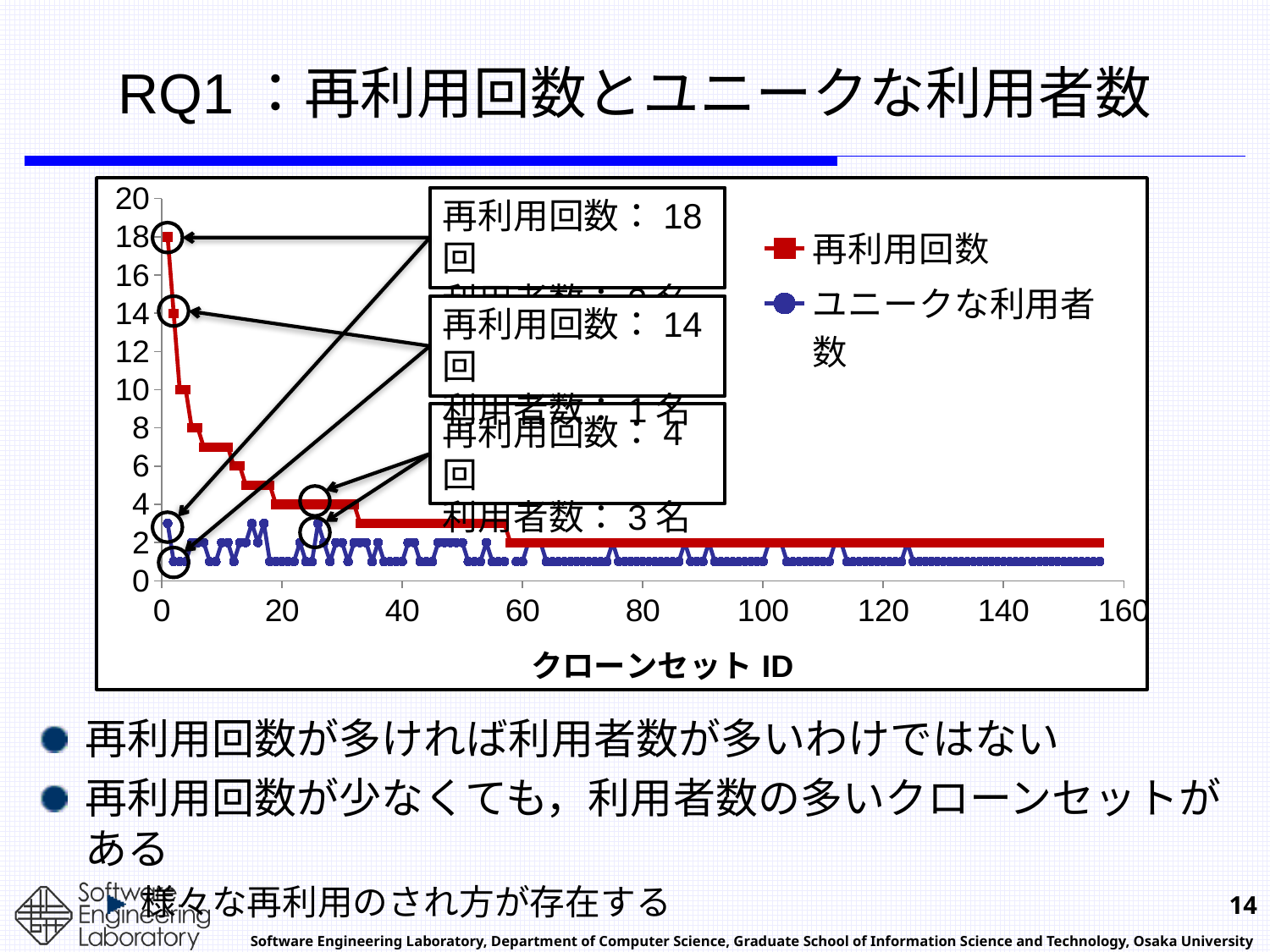
According to the callout, how many users (利用者数) does the clone set with 14 reuses have? 1名 What are the two series named in the legend? 再利用回数 and ユニークな利用者数 What kind of chart is shown on the slide? line chart What is the highest value of 再利用回数 shown on the chart? 18 What is the difference between the 再利用回数 values of 18 and 14 highlighted in the callouts? 4 According to the callout, how many users (利用者数) does the clone set with 4 reuses have? 3名 Does 再利用回数 rise or fall as クローンセット ID increases? fall Is the value of 再利用回数 at クローンセット ID 100 greater or less than 4? less At クローンセット ID 1, which series has the larger value, 再利用回数 or ユニークな利用者数? 再利用回数 What is the title of the x axis? クローンセット ID Is the value of 再利用回数 at クローンセット ID 1 greater or less than 10? greater How many series does the chart legend list? 2